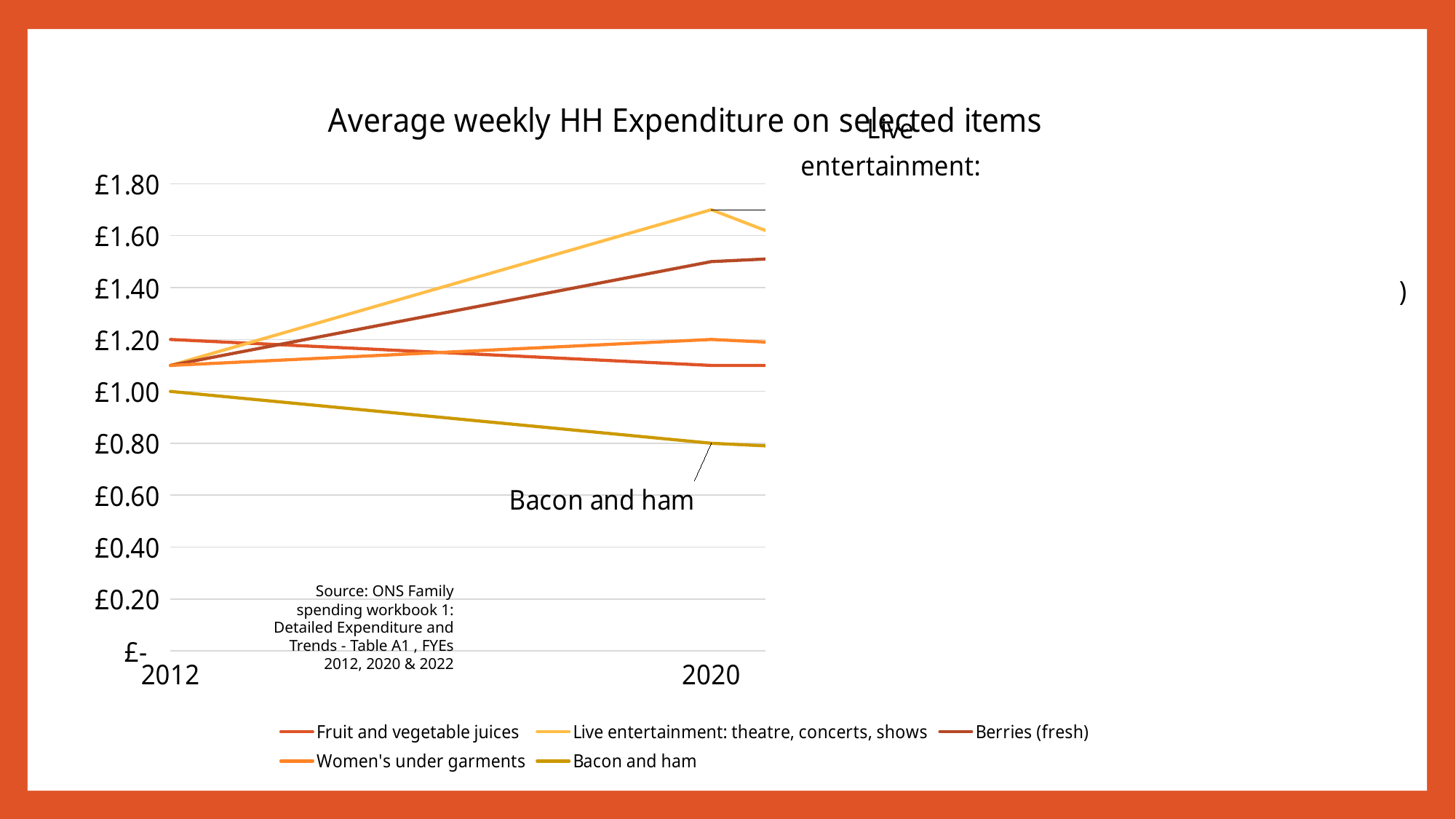
What is the title of the chart? Average weekly HH Expenditure on selected items What is the value for Bacon and ham in 2012? £1.00 Is the value for Berries (fresh) in 2020 greater or less than £1.40? greater Does the value for Bacon and ham rise or fall from 2012 to 2020? fall Does the value for Live entertainment: theatre, concerts, shows rise or fall from 2012 to 2020? rise What is the value for Fruit and vegetable juices in 2012? £1.20 Which series has the lowest value in 2020? Bacon and ham Which series has the highest value in 2020? Live entertainment: theatre, concerts, shows Is the value for Bacon and ham in 2020 greater or less than £1.00? less In 2020, which is larger: Berries (fresh) or Fruit and vegetable juices? Berries (fresh) How many series does the legend list? 5 What kind of chart is shown on the slide? line chart